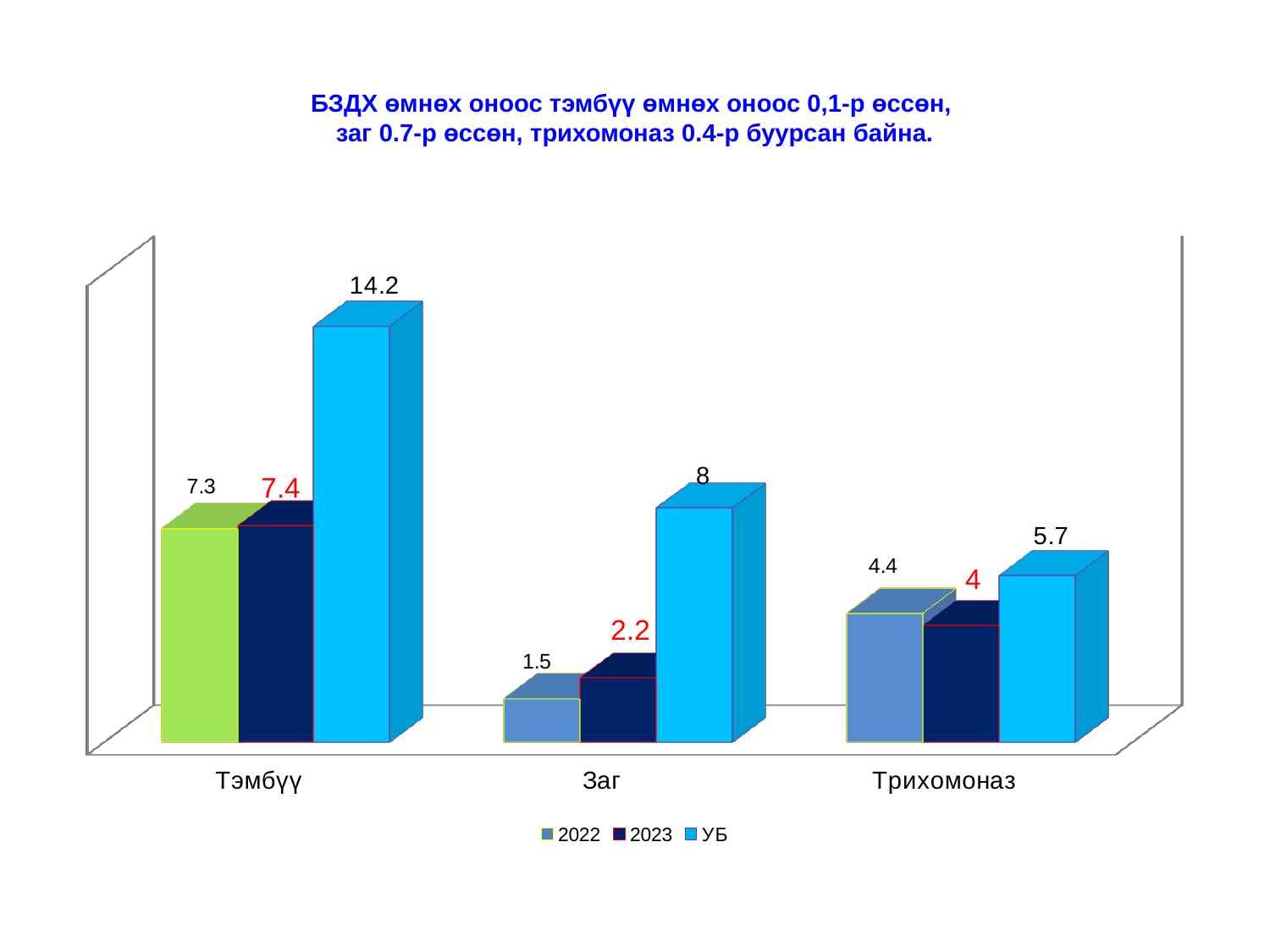
How many categories are shown on the x axis? 3 What is the difference between the УБ value and the 2023 value for Тэмбүү? 6.8 What is the 2023 value for Заг? 2.2 What is the 2023 value for Трихомоназ? 4 What is the 2022 value for Трихомоназ? 4.4 What is the difference between the 2023 and 2022 values for Заг? 0.7 What kind of chart is shown on the slide? Bar chart How many series does the legend list? 3 What is the value for Тэмбүү in the УБ series? 14.2 Which category has the highest УБ value? Тэмбүү Which category has the lowest 2022 value? Заг Which is larger for Трихомоназ, the 2022 value or the 2023 value? 2022